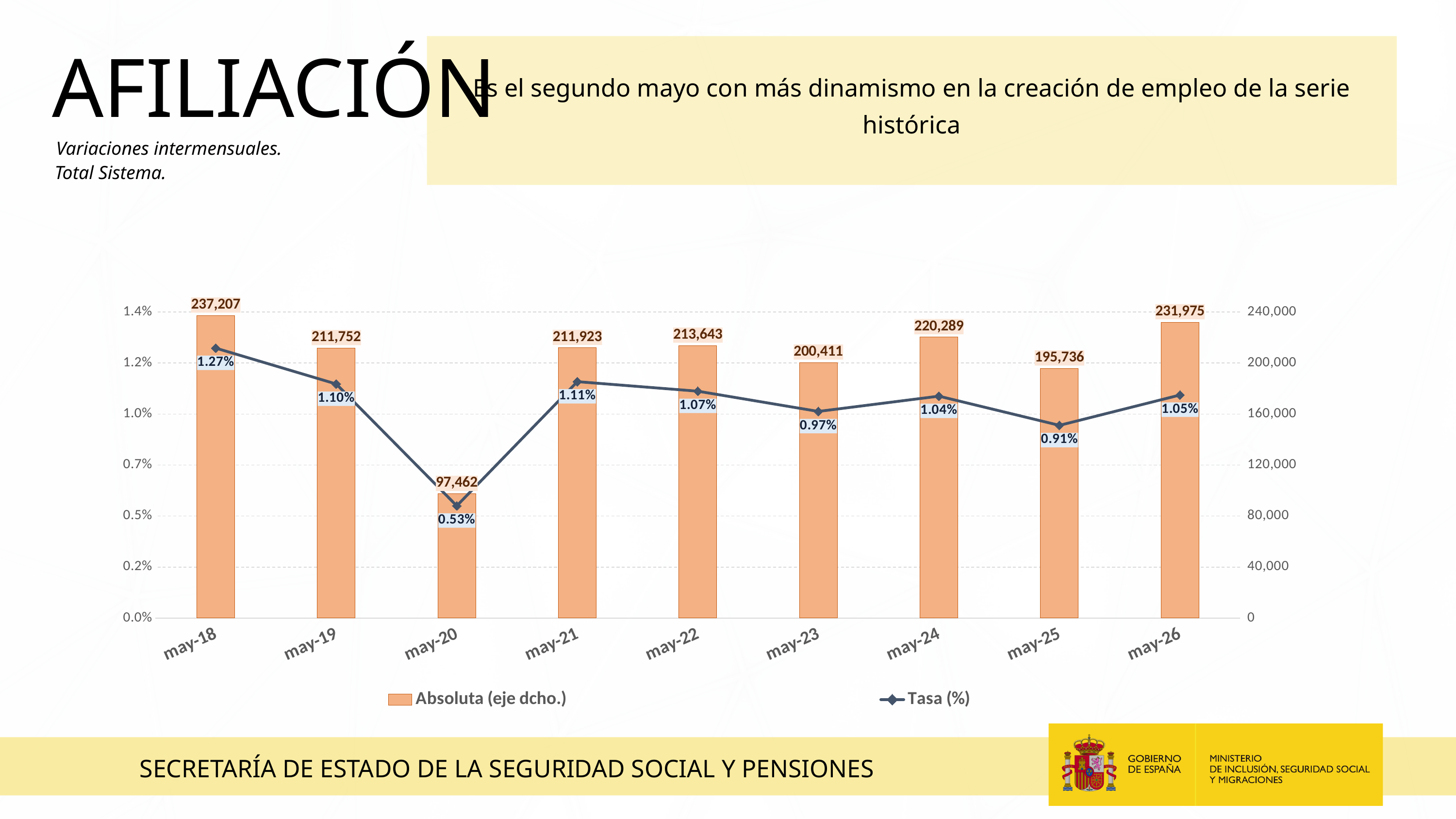
What is the Absoluta value for may-26? 231,975 Which series is plotted on the right axis according to the legend? Absoluta (eje dcho.) Which category has the highest Tasa (%) value? may-18 What kind of chart is this? Combined bar and line chart What is the Absoluta value for may-18? 237,207 How many series does the legend list? 2 Which category has the lowest Absoluta value? may-20 Does the Tasa (%) line rise or fall from may-18 to may-20? Fall What is the Tasa (%) value for may-25? 0.91% How many categories are shown on the x axis? 9 Which is larger, the Absoluta value for may-24 or for may-22? may-24 What is the difference between the Absoluta values for may-18 and may-26? 5,232